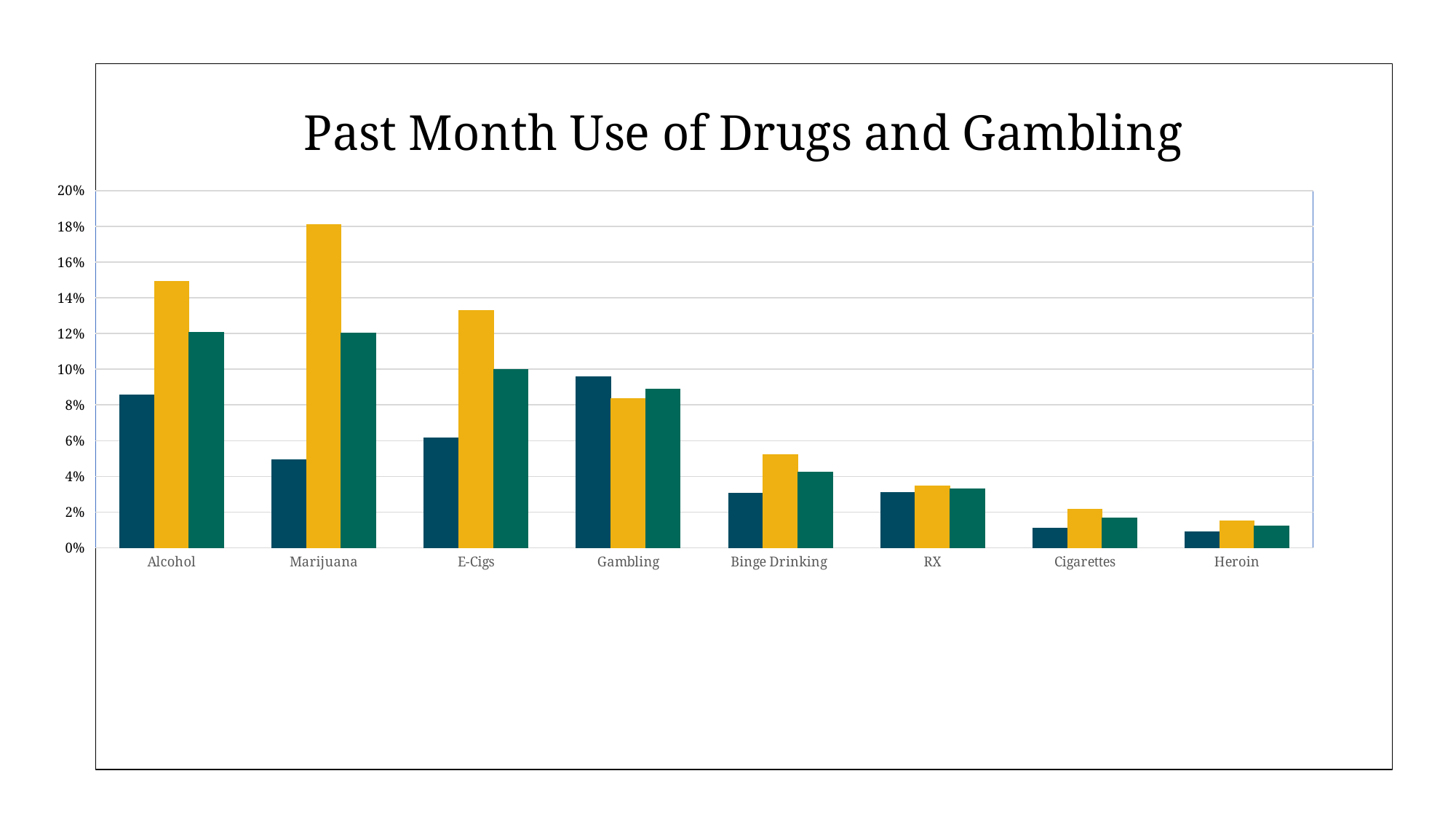
How many bars are plotted for each category? 3 What is the title of the chart? Past Month Use of Drugs and Gambling How many categories are shown along the x axis? 8 Which category has the lowest bars in the chart? Heroin What kind of chart is shown on the slide? bar chart Which is larger, the yellow bar for Alcohol or the yellow bar for Gambling? Alcohol Is the dark blue bar for Cigarettes greater or less than 2%? less Which category has the tallest bar in the chart? Marijuana Is the yellow bar for Marijuana greater or less than 16%? greater Is the yellow bar for Alcohol greater or less than 12%? greater